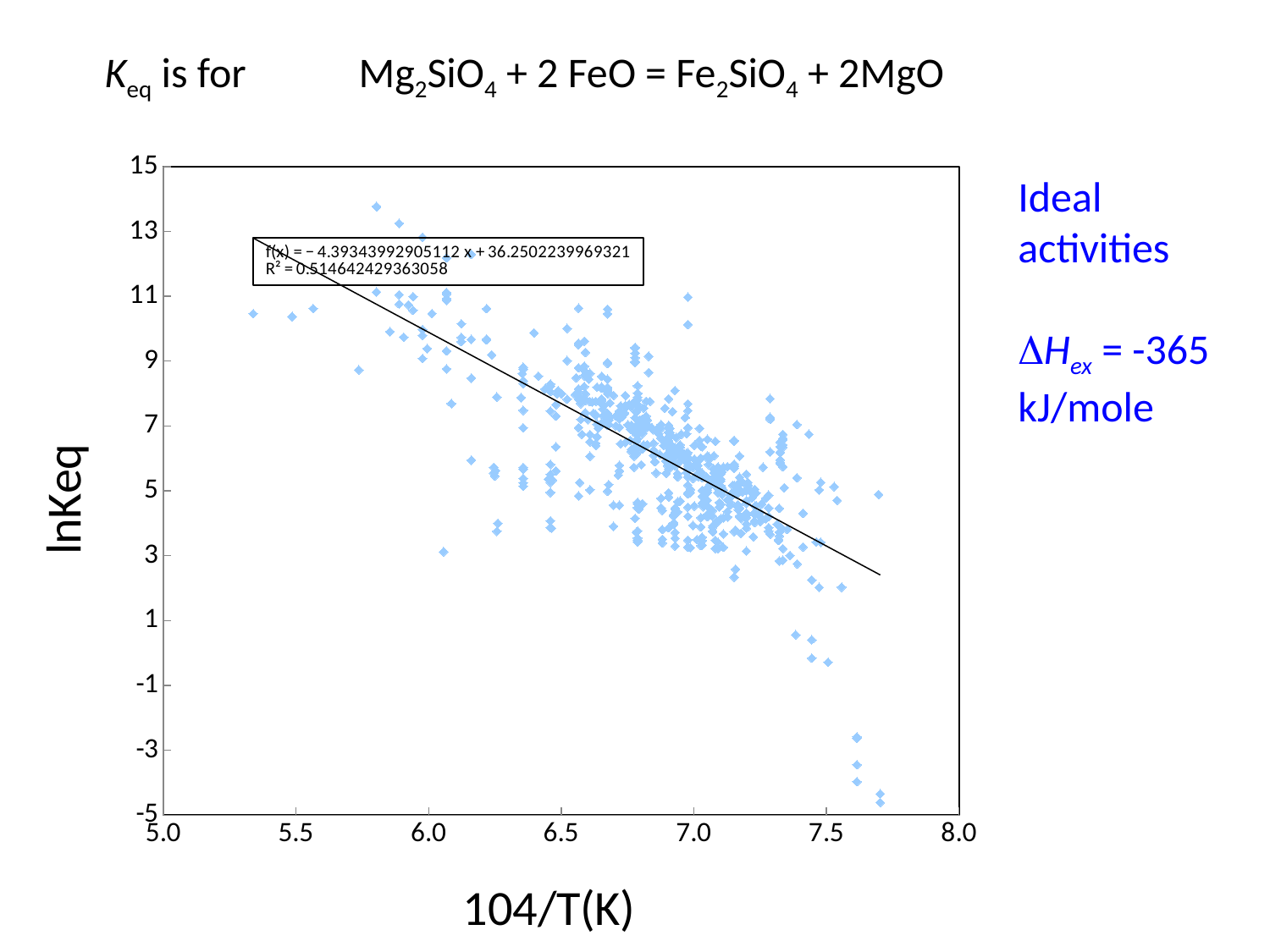
Is the value of the fitted line at 104/T(K) = 7.5 greater or less than 5? less Is the value of the fitted line at 104/T(K) = 5.5 greater or less than 11? greater What is the label of the x axis? 104/T(K) What is the intercept of the fitted line f(x) printed on the chart? 36.2502239969321 Is the highest plotted lnKeq value greater or less than 13? greater What is the R² value printed on the chart for the fitted line? 0.514642429363058 What is the slope of the fitted line f(x) printed on the chart? -4.39343992905112 What kind of chart is shown on the slide? scatter chart What is the label of the y axis? lnKeq Do the lnKeq values generally rise or fall as 104/T(K) increases along the x axis? fall